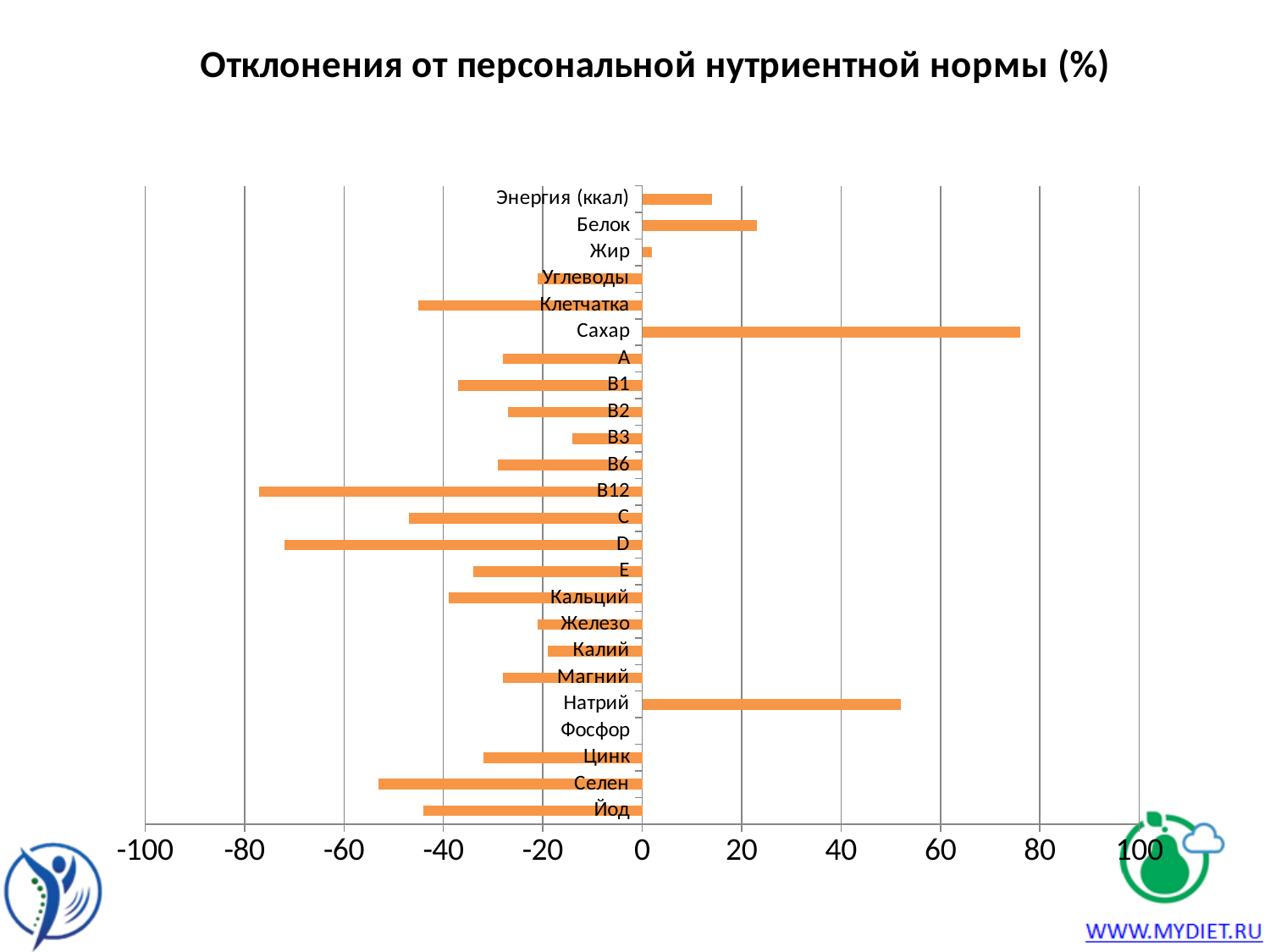
Is the value for Натрий greater or less than 40? greater What kind of chart is shown on the slide? bar chart Which category shows no visible bar on the chart? Фосфор How many categories are plotted on the chart? 24 Which is larger, the value for Белок or the value for Энергия (ккал)? Белок Is the value for Сахар greater or less than 60? greater What is the title of the chart? Отклонения от персональной нутриентной нормы (%) Is the value for Клетчатка greater or less than -40? less Which category has the lowest value? B12 Which category has the highest value? Сахар Which is larger, the value for Сахар or the value for Натрий? Сахар